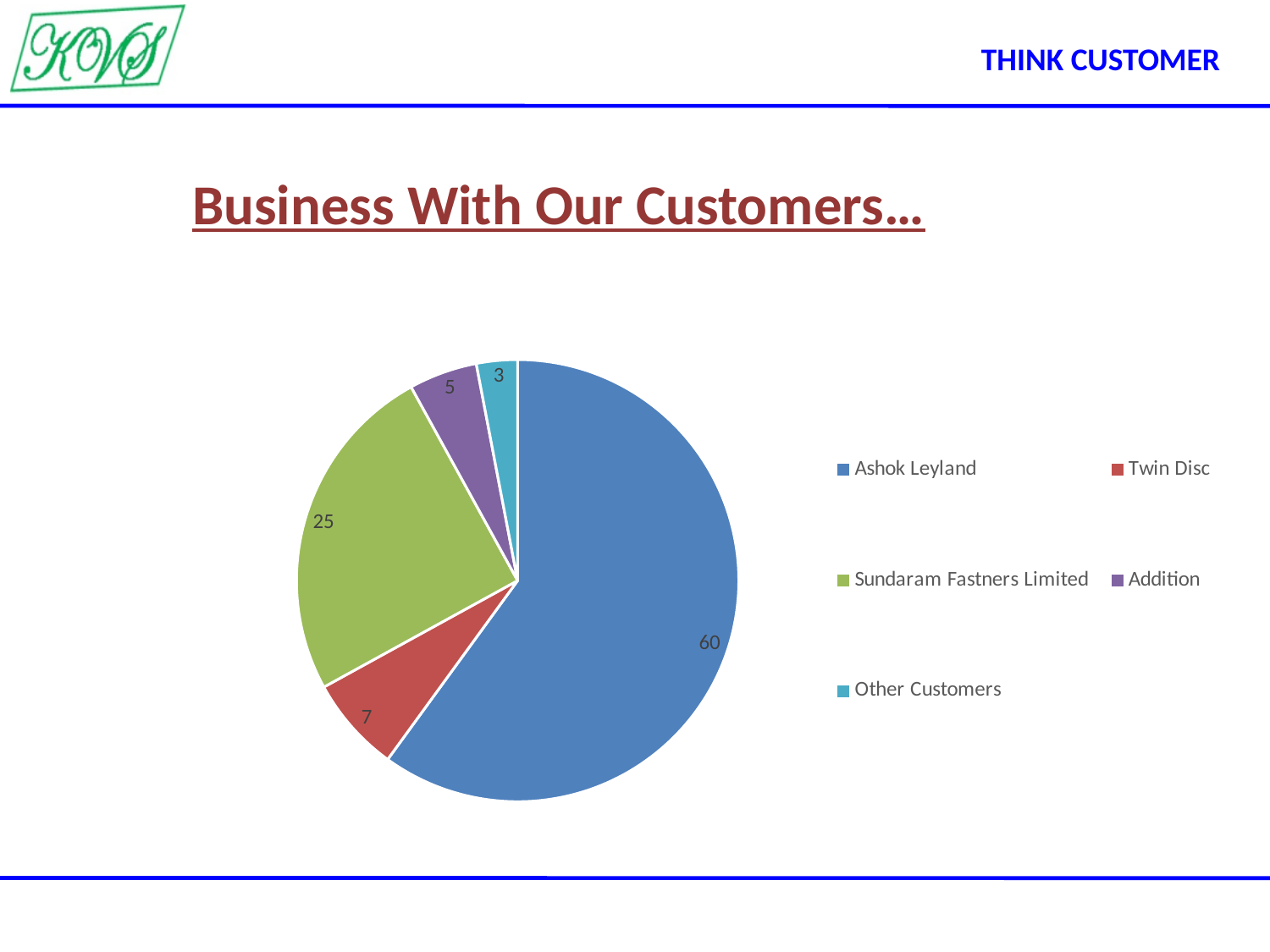
What is the value for Ashok Leyland? 60 Which is larger, the value for Twin Disc or the value for Addition? Twin Disc Which customer has the largest slice of the pie? Ashok Leyland What is the value for Twin Disc? 7 What is the value for Other Customers? 3 What is the difference between the values for Ashok Leyland and Sundaram Fastners Limited? 35 Which customer has the smallest slice of the pie? Other Customers What is the value for Sundaram Fastners Limited? 25 What kind of chart is shown on the slide? Pie chart What is the title of the slide containing the chart? Business With Our Customers… How many slices does the pie chart have? 5 What share of the pie does Sundaram Fastners Limited represent? 25%